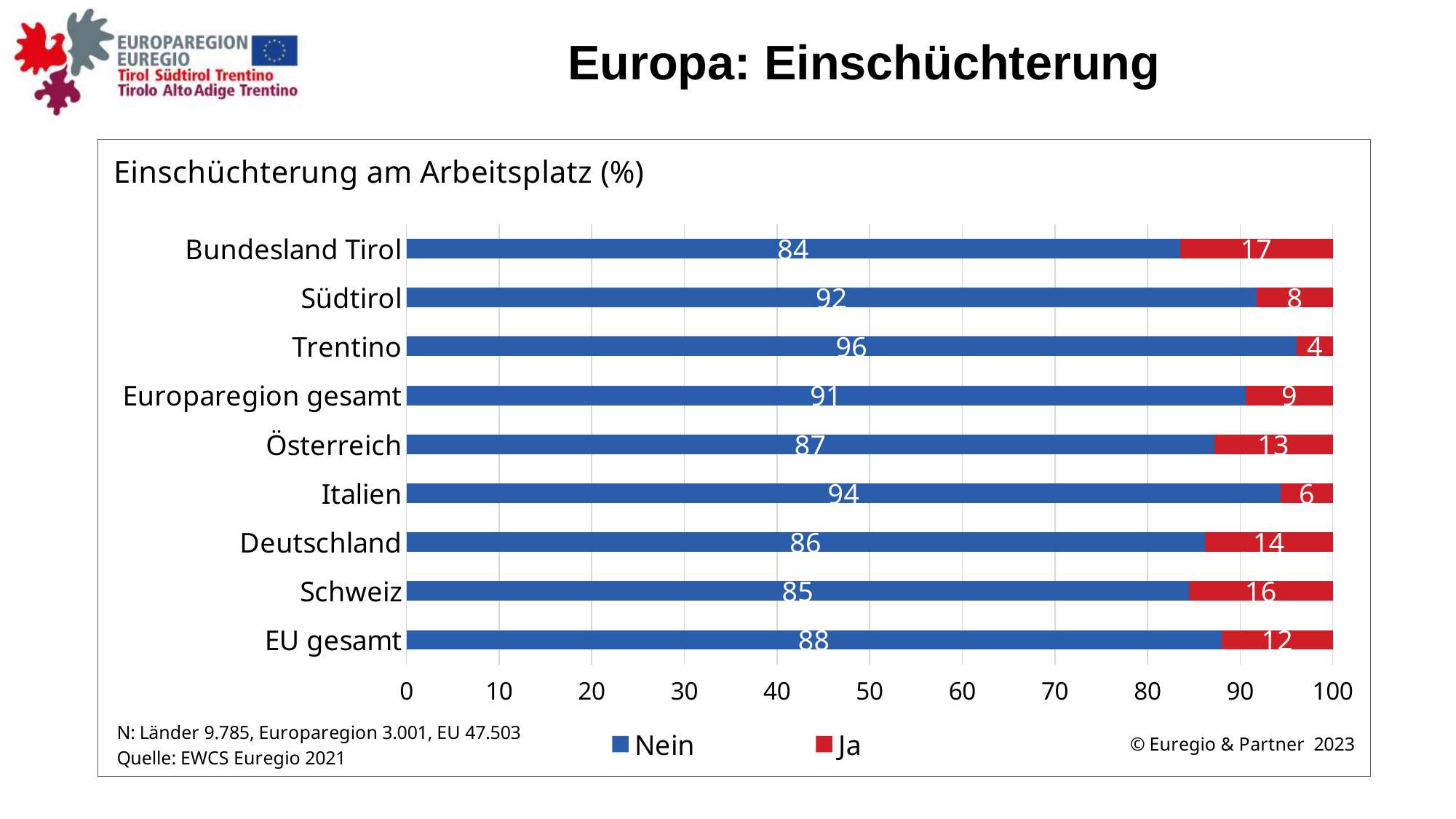
What is the 'Ja' value for EU gesamt? 12 What is the 'Ja' value for Bundesland Tirol? 17 How many categories are shown on the y axis? 9 Which has a larger 'Nein' value, Südtirol or Österreich? Südtirol What is the title of the chart? Einschüchterung am Arbeitsplatz (%) What kind of chart is shown? Stacked bar chart Which category has the highest 'Ja' value? Bundesland Tirol Is the 'Nein' value for Italien greater or less than 90? greater Which category has the lowest 'Ja' value? Trentino How many series does the legend list? 2 What is the 'Nein' value for Trentino? 96 What is the difference between the 'Ja' values for Schweiz and Deutschland? 2